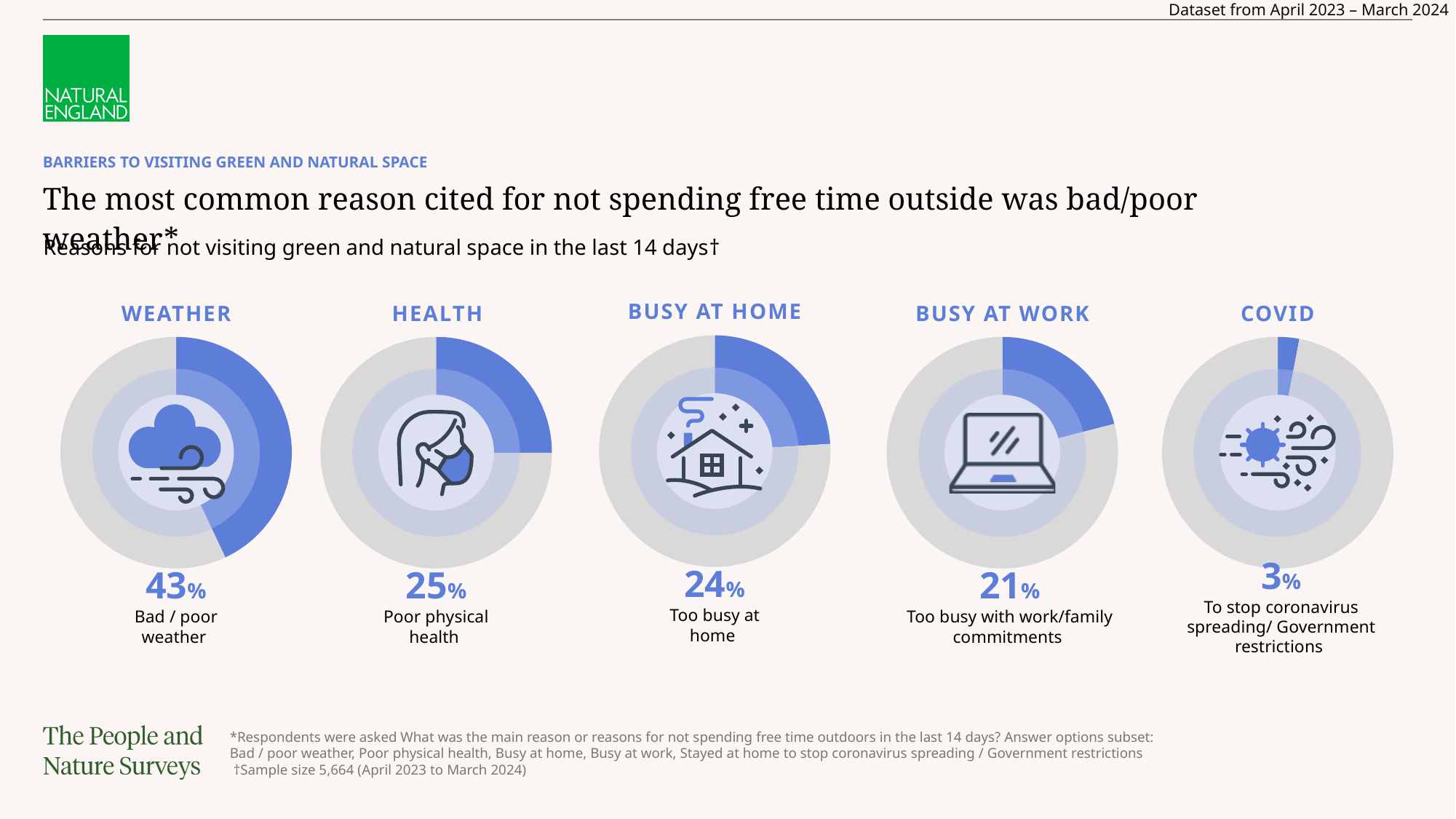
On the Busy at Work chart, what percentage cited being too busy with work/family commitments? 21% On the Weather chart, what percentage of respondents cited bad / poor weather as a reason for not visiting green and natural space? 43% What kind of chart is used to show each reason on the slide? Donut (pie) chart What is the difference in percentage points between the Weather chart value and the Health chart value? 18 On the Health chart, what percentage cited poor physical health? 25% Which is larger: the Busy at Home chart value or the Busy at Work chart value? Busy at Home What is the difference in percentage points between the Busy at Work chart value and the Covid chart value? 18 On the Covid chart, what percentage cited stopping coronavirus spreading / Government restrictions? 3% How many donut charts are shown on the slide? 5 Across the five charts, which reason has the highest percentage? Weather (Bad / poor weather) On the Busy at Home chart, what percentage cited being too busy at home? 24% Across the five charts, which reason has the lowest percentage? Covid